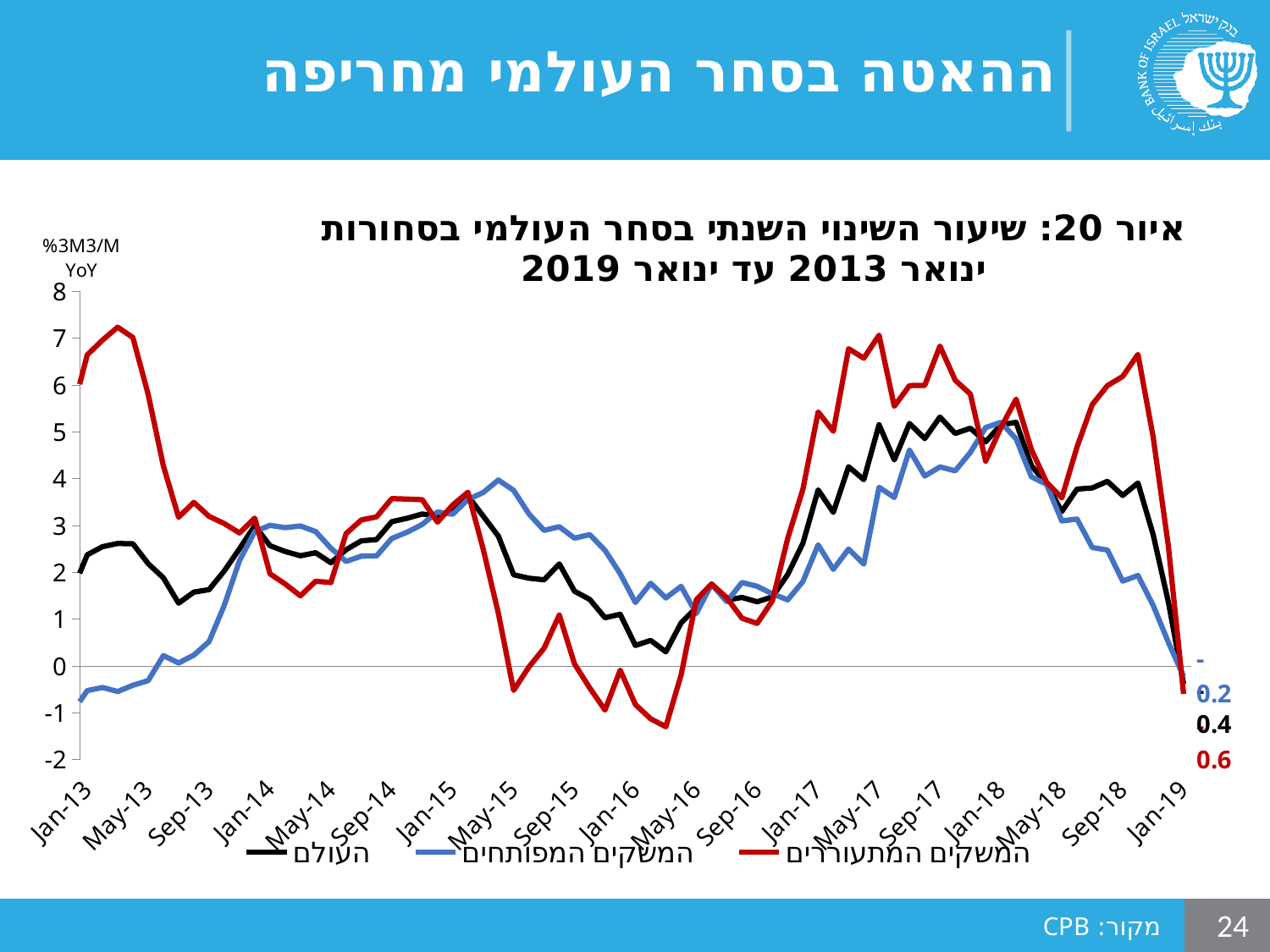
Is the value for המשקים המתעוררים at May-16 greater or less than 0? greater Which series is drawn in red? המשקים המתעוררים What kind of chart is shown on the slide? line chart Is the value for העולם at Jan-18 greater or less than 4? greater At Jan-16, which is larger: the value for המשקים המפותחים or the value for המשקים המתעוררים? המשקים המפותחים Is the value for המשקים המתעוררים at Jan-13 greater or less than 5? greater Which series has the highest value at Jan-13? המשקים המתעוררים Which series is drawn in blue? המשקים המפותחים How many series does the legend list? 3 Which series has the lowest value at Jan-13? המשקים המפותחים Do the values for העולם rise or fall between Sep-18 and Jan-19? fall